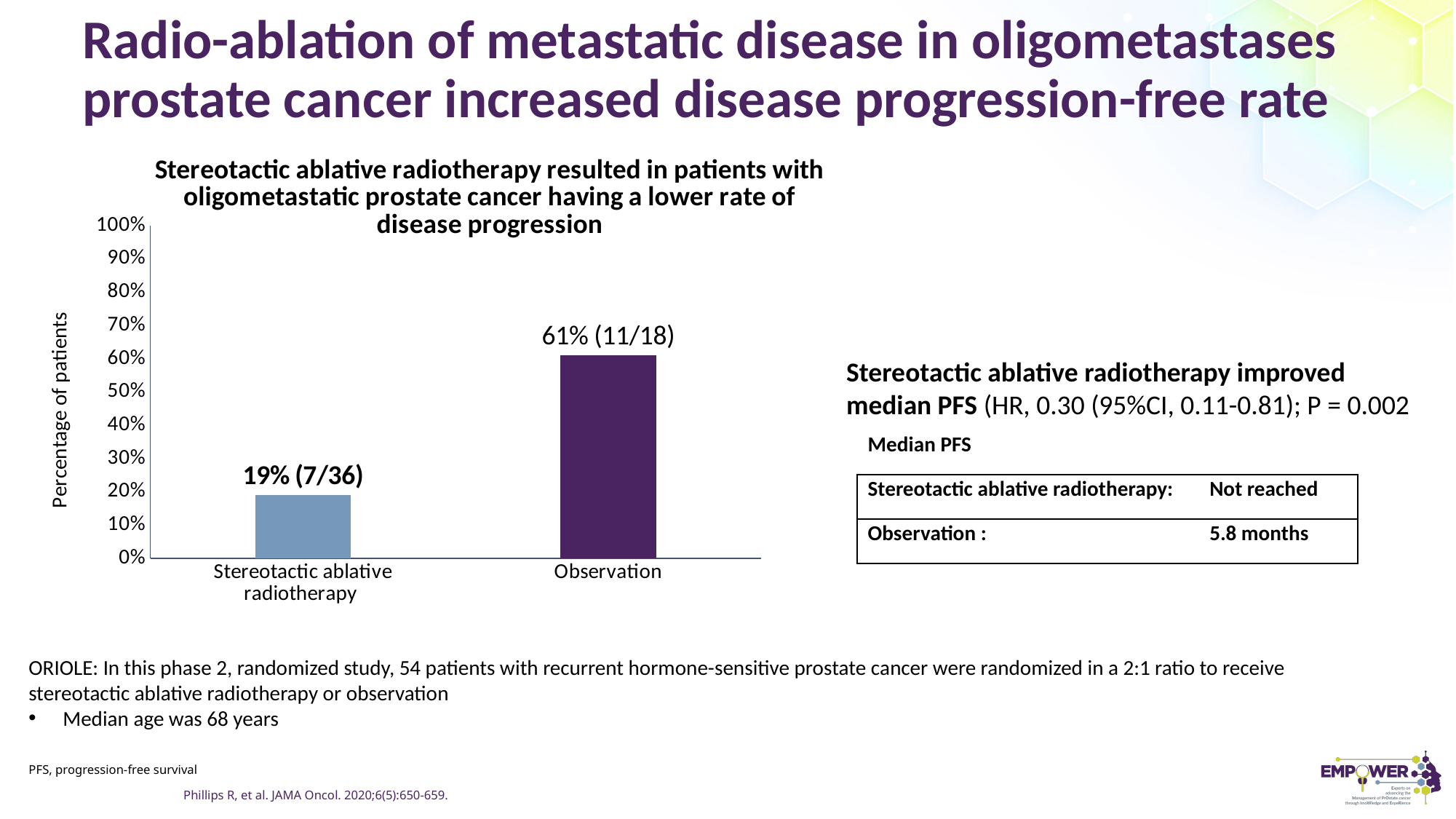
Is the value for Stereotactic ablative radiotherapy greater or less than 30%? less What kind of chart is shown? Bar chart What is the value for Observation? 61% (11/18) What is the value for Stereotactic ablative radiotherapy? 19% (7/36) What is the title of the chart? Stereotactic ablative radiotherapy resulted in patients with oligometastatic prostate cancer having a lower rate of disease progression What is the label of the y axis? Percentage of patients Which is larger, the value for Observation or the value for Stereotactic ablative radiotherapy? Observation Which category has the lowest percentage of patients? Stereotactic ablative radiotherapy What is the difference in percentage points between Observation and Stereotactic ablative radiotherapy? 42% How many categories are shown on the x axis? 2 Which category has the highest percentage of patients? Observation Is the value for Observation greater or less than 50%? greater